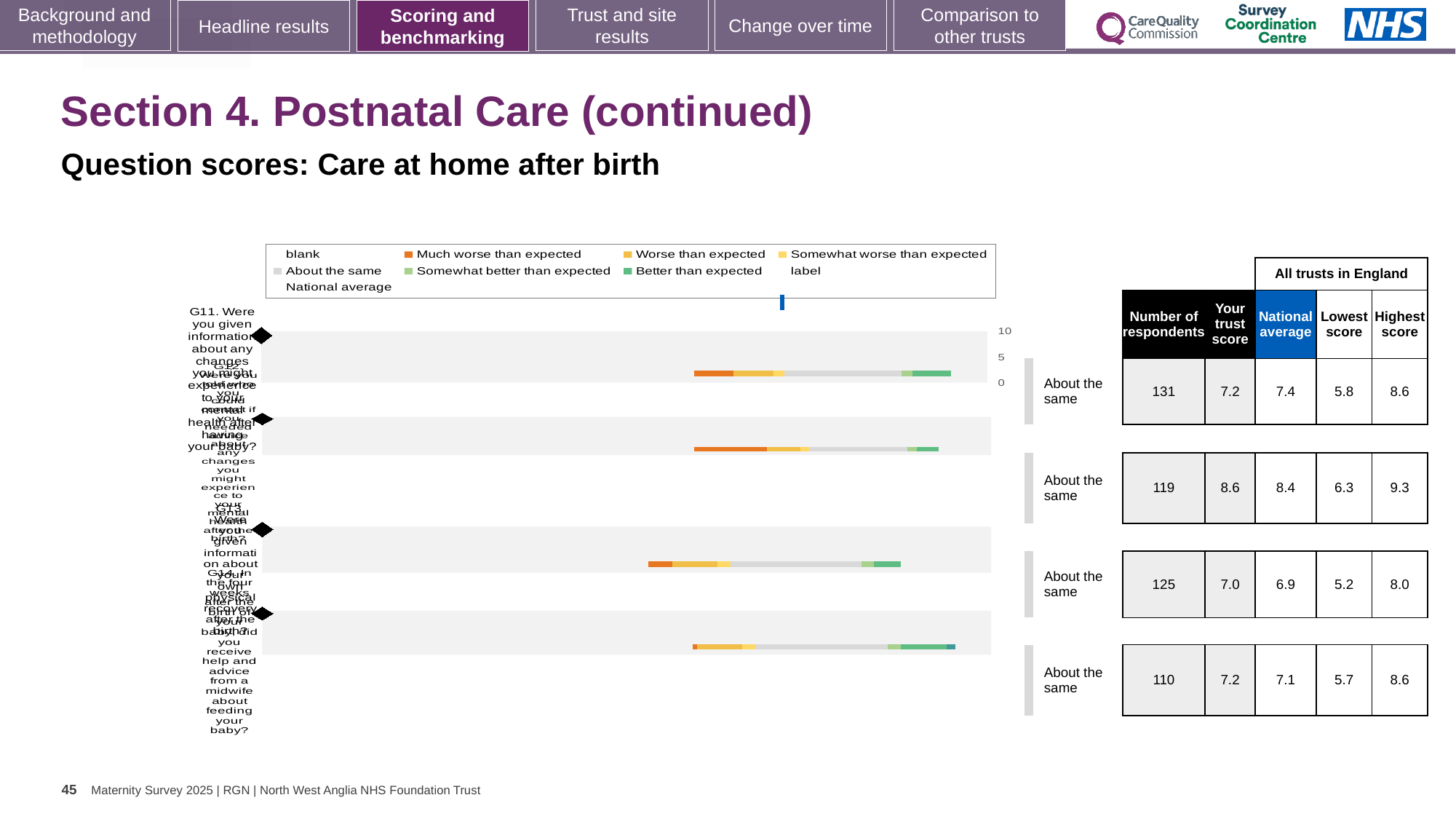
In the table, what is the lowest score for the fourth row? 5.7 What kind of chart is shown on the slide? bar chart In the table, what is the number of respondents for the first row? 131 In the first row of the table, which is larger: the trust score or the national average? the national average (7.4) In the second row of the table, what is the difference between the highest score and the lowest score? 3.0 What heading appears above the National average, Lowest score and Highest score columns? All trusts in England How many bars (question rows) does the chart show? 4 In the table, what is the national average for the third row? 6.9 In the table, what is the 'Your trust score' for the second row? 8.6 What colour represents 'Much worse than expected' in the legend? orange Which row of the table has the lowest number of respondents? the fourth row (110) Which row of the table has the highest 'Your trust score'? the second row (8.6)